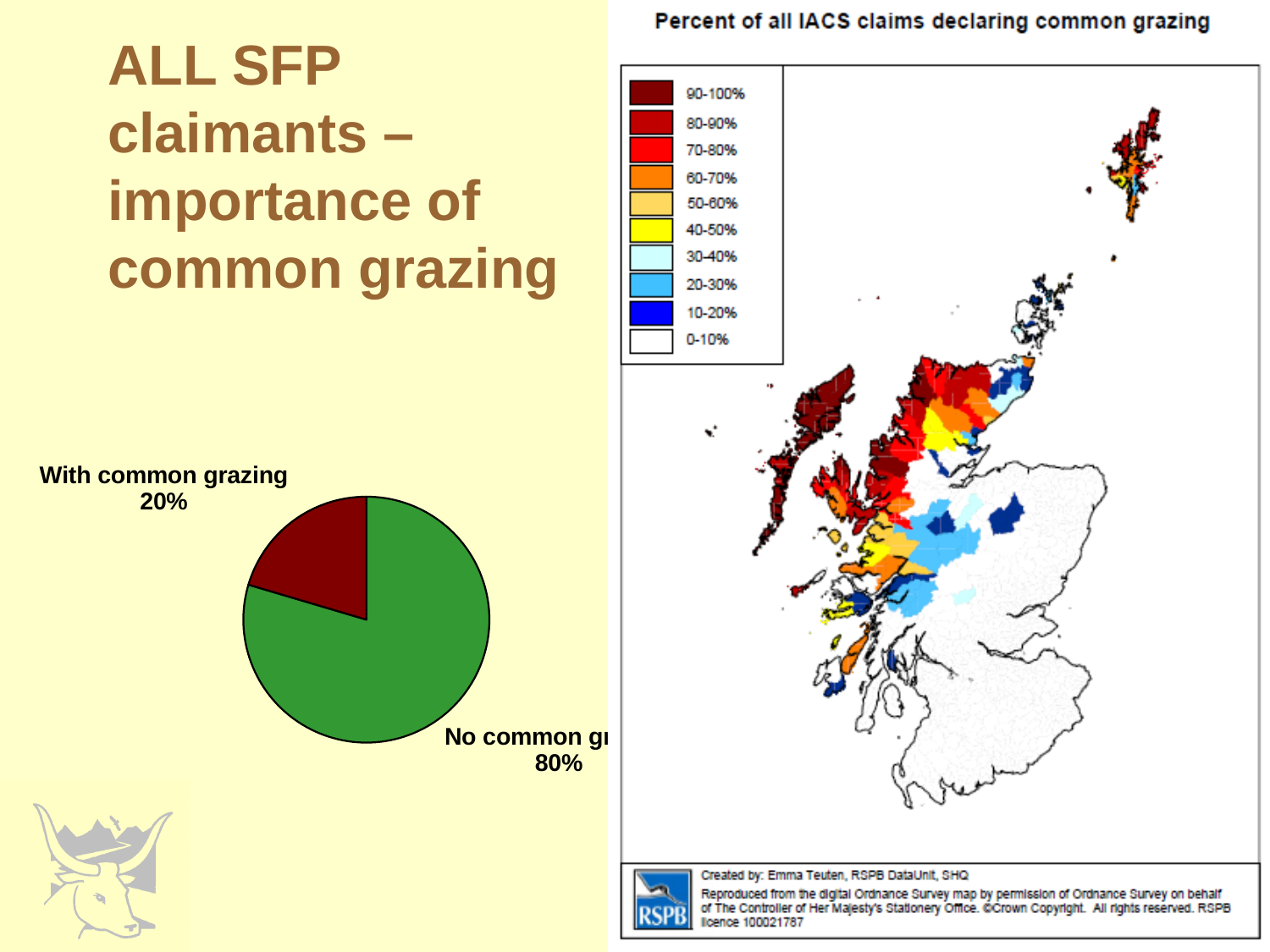
What colour is the 'With common grazing' slice in the pie chart? Dark red What kind of chart is shown on the left side of the slide? Pie chart In the pie chart, what percentage is shown for the larger, green slice (No common grazing)? 80% In the pie chart, what percentage of SFP claimants are shown as 'With common grazing'? 20% What share of the pie chart does the 'With common grazing' slice represent? 20% Which slice of the pie chart is the smallest? With common grazing Which slice of the pie chart is the largest? No common grazing In the pie chart, what is the difference in percentage points between the 'No common grazing' slice and the 'With common grazing' slice? 60 percentage points In the pie chart, which is larger: the 'With common grazing' slice or the 'No common grazing' slice? No common grazing What is the title of the map on the right side of the slide? Percent of all IACS claims declaring common grazing How many slices does the pie chart have? 2 Is the 'With common grazing' share in the pie chart greater or less than 50%? less